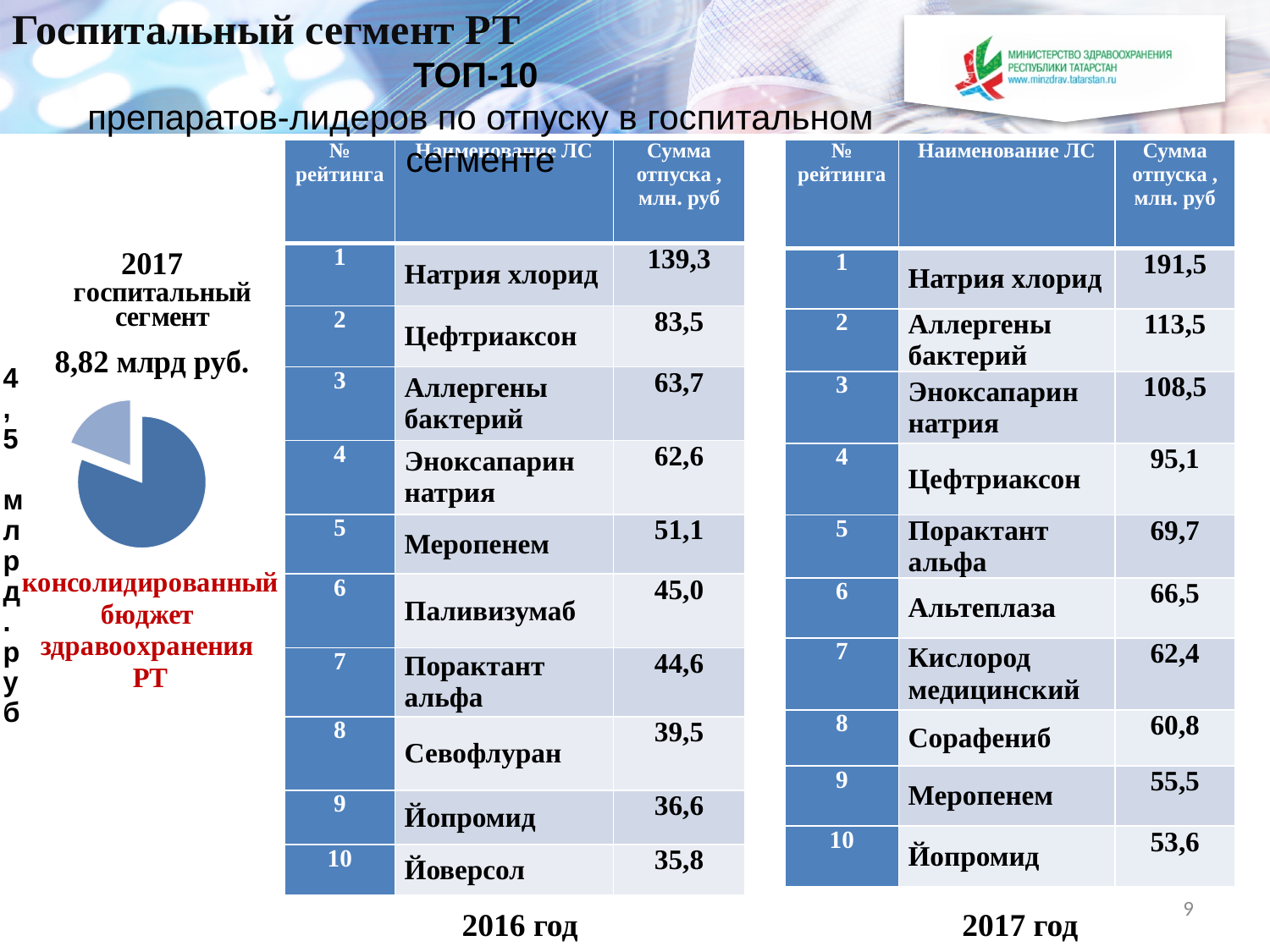
What kind of chart is shown on the left side of the slide? pie chart How many slices does the pie chart on the left of the slide have? 2 In the pie chart on the left of the slide, is the light blue slice more or less than half of the pie? less What year is written in the heading above the pie chart on the left of the slide? 2017 In the pie chart on the left of the slide, which slice is larger, the dark blue one or the light blue one? the dark blue one What colour is the largest slice of the pie chart on the left of the slide? dark blue